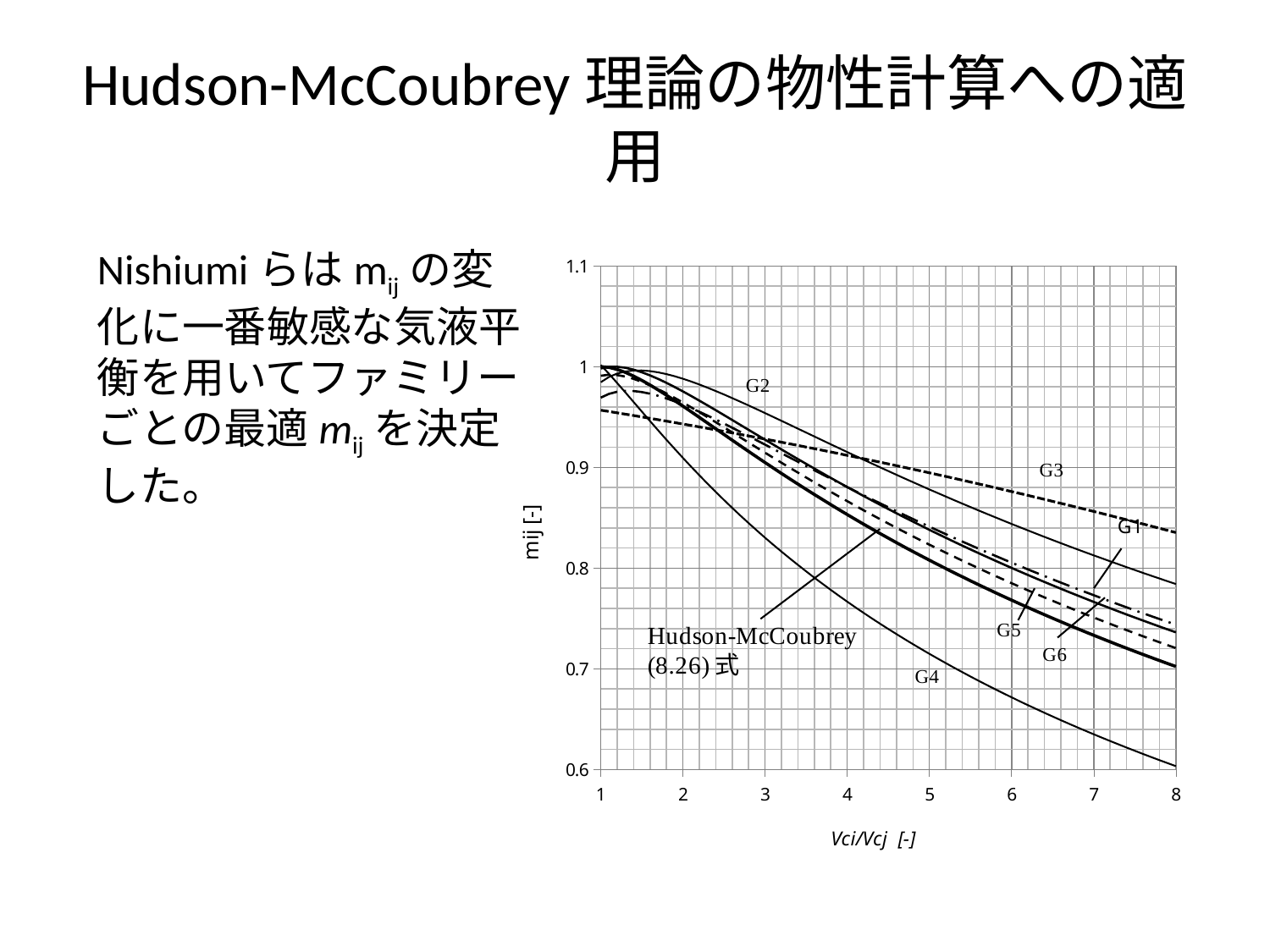
What is the maximum value shown on the y axis of the chart? 1.1 How many labeled curves are plotted on the chart? 7 Is the value of the G3 curve at Vci/Vcj = 8 greater or less than 0.8? greater What is the label of the x axis of the chart? Vci/Vcj [-] Is the value of the G4 curve at Vci/Vcj = 8 greater or less than 0.7? less What kind of chart is shown on the slide? line chart At Vci/Vcj = 8, which curve has the larger value, G3 or G4? G3 Which labeled curve has the lowest value at Vci/Vcj = 8? G4 Do the curves generally rise or fall as Vci/Vcj increases from 1 to 8? fall Which labeled curve has the highest value at Vci/Vcj = 8? G3 At Vci/Vcj = 8, which curve has the larger value, G2 or G6? G2 Is the value of the G4 curve at Vci/Vcj = 5 greater or less than 0.8? less